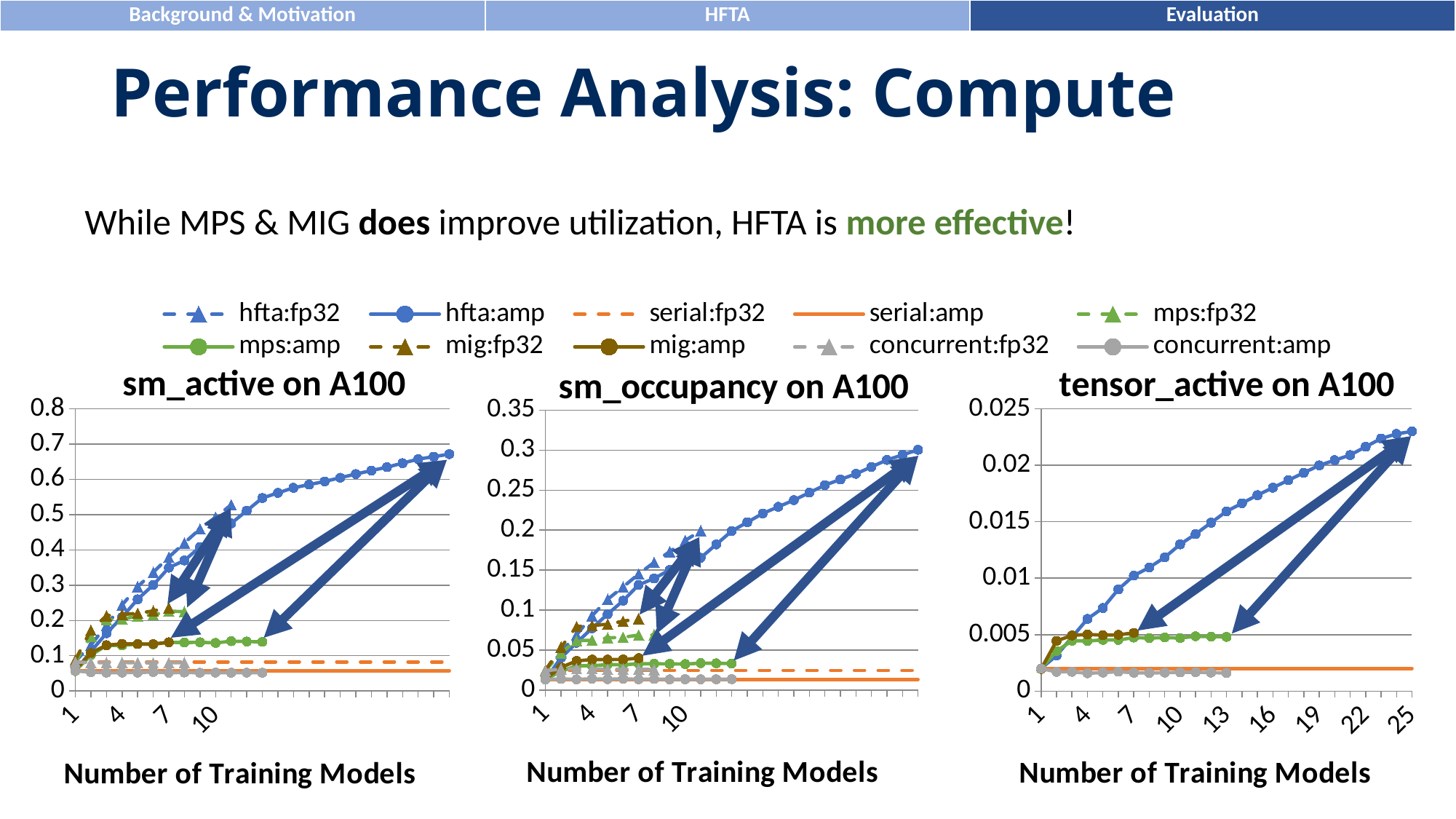
In the sm_active on A100 chart, is the value for concurrent:amp greater or less than 0.1? less In the tensor_active on A100 chart, is the value for serial:amp greater or less than 0.005? less What is the x-axis label of the sm_occupancy on A100 chart? Number of Training Models How many series does the shared legend list? 10 In the sm_active on A100 chart, is the highest value reached by hfta:amp greater or less than 0.6? greater How many charts are shown on the slide? 3 What is the title of the rightmost chart? tensor_active on A100 What kind of chart is the sm_active on A100 chart? line chart In the tensor_active on A100 chart, does the hfta:amp series rise or fall as the number of training models increases? rise In the sm_active on A100 chart, which series is higher at 10 training models, hfta:amp or mps:amp? hfta:amp